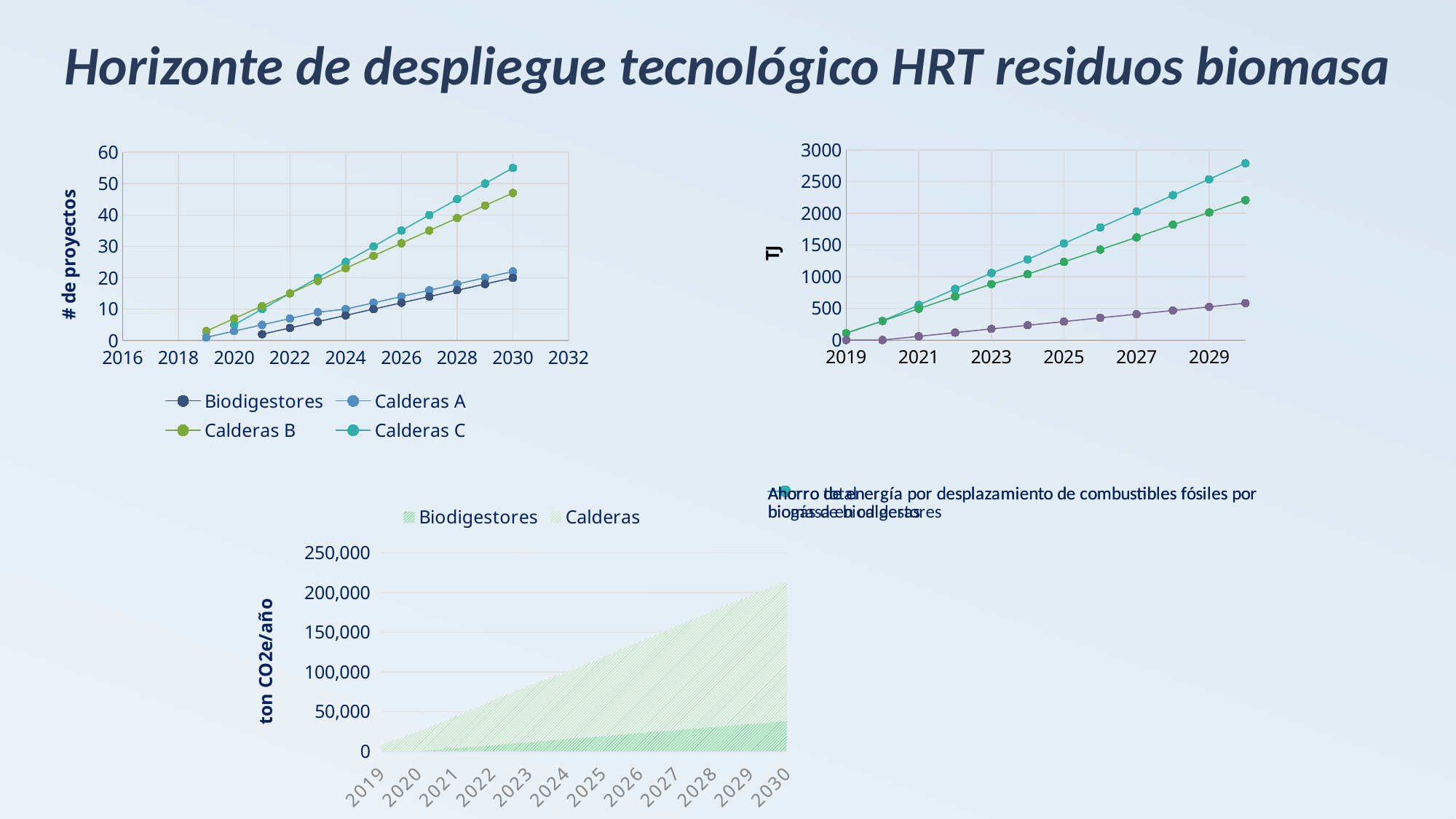
In the bottom chart (ton CO2e/año), which series is larger in 2030, Biodigestores or Calderas? Calderas What is the y-axis label of the bottom chart? ton CO2e/año In the top-left chart (# de proyectos), which series has the highest value in 2030? Calderas C In the top-left chart (# de proyectos), which series has the lowest value in 2030? Biodigestores In the top-left chart (# de proyectos), is the value for Calderas B in 2030 greater or less than 50? less In the top-left chart (# de proyectos), how many series does the legend list? 4 What kind of chart is the top-right chart (TJ)? line chart In the top-right chart (TJ), how many lines are plotted? 3 In the top-left chart (# de proyectos), do the values for Calderas B rise or fall from 2019 to 2030? rise In the top-right chart (TJ), is the highest value plotted in 2030 greater or less than 2500? greater In the bottom chart (ton CO2e/año), is the value for Biodigestores in 2030 greater or less than 50,000? less